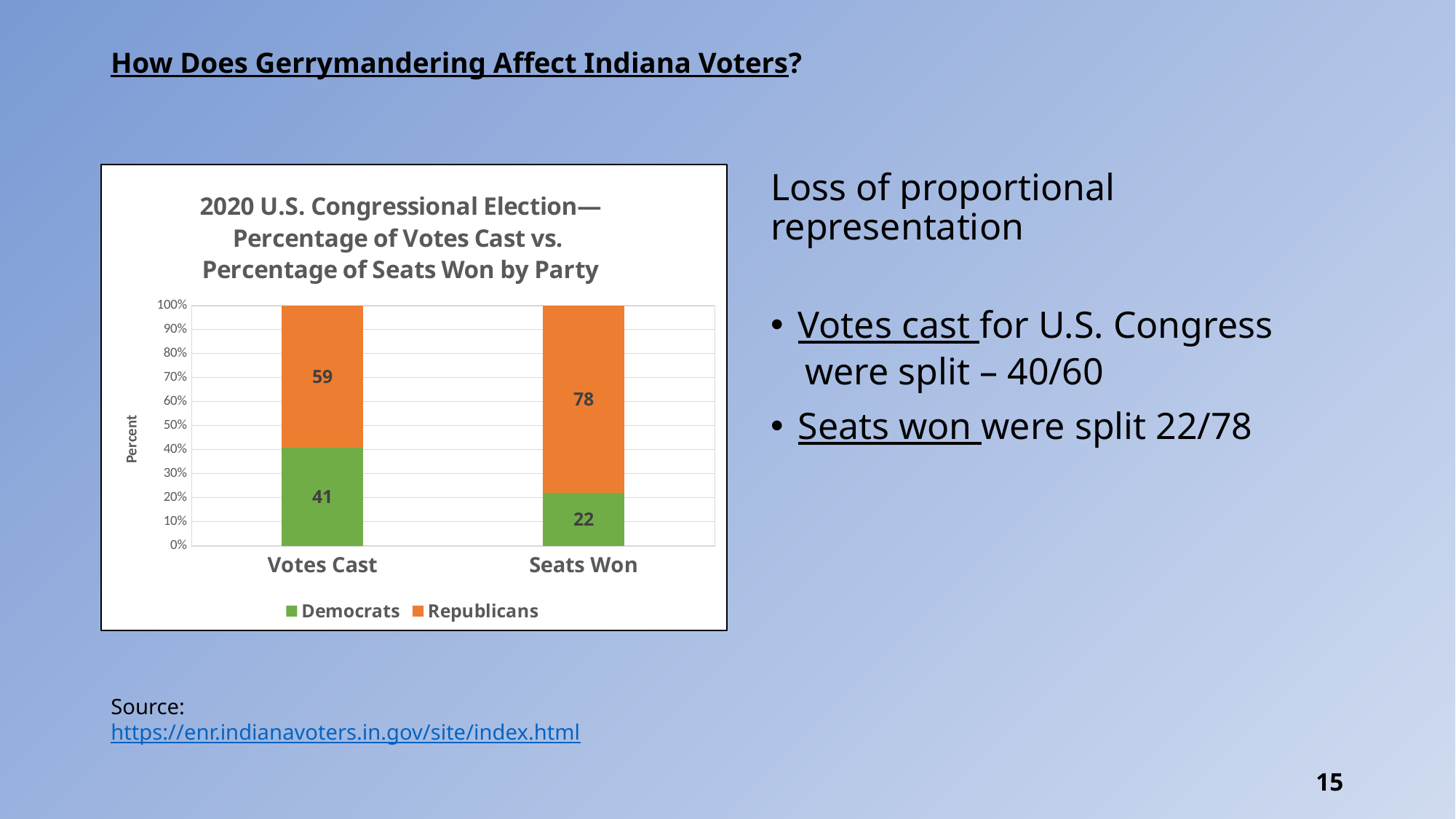
What is the difference between the Republican values for Seats Won and Votes Cast? 19 How many series does the legend list? 2 Which category has the lowest Democrat value? Seats Won What is the value for Democrats in the Votes Cast bar? 41 How many categories are shown on the x axis? 2 Which is larger, the Democrat value for Votes Cast or the Democrat value for Seats Won? Votes Cast What is the value for Democrats in the Seats Won bar? 22 What is the difference between the Democrat values for Votes Cast and Seats Won? 19 What is the value for Republicans in the Seats Won bar? 78 Which category has the highest Republican value? Seats Won What is the value for Republicans in the Votes Cast bar? 59 What kind of chart is shown on the slide? Stacked bar chart